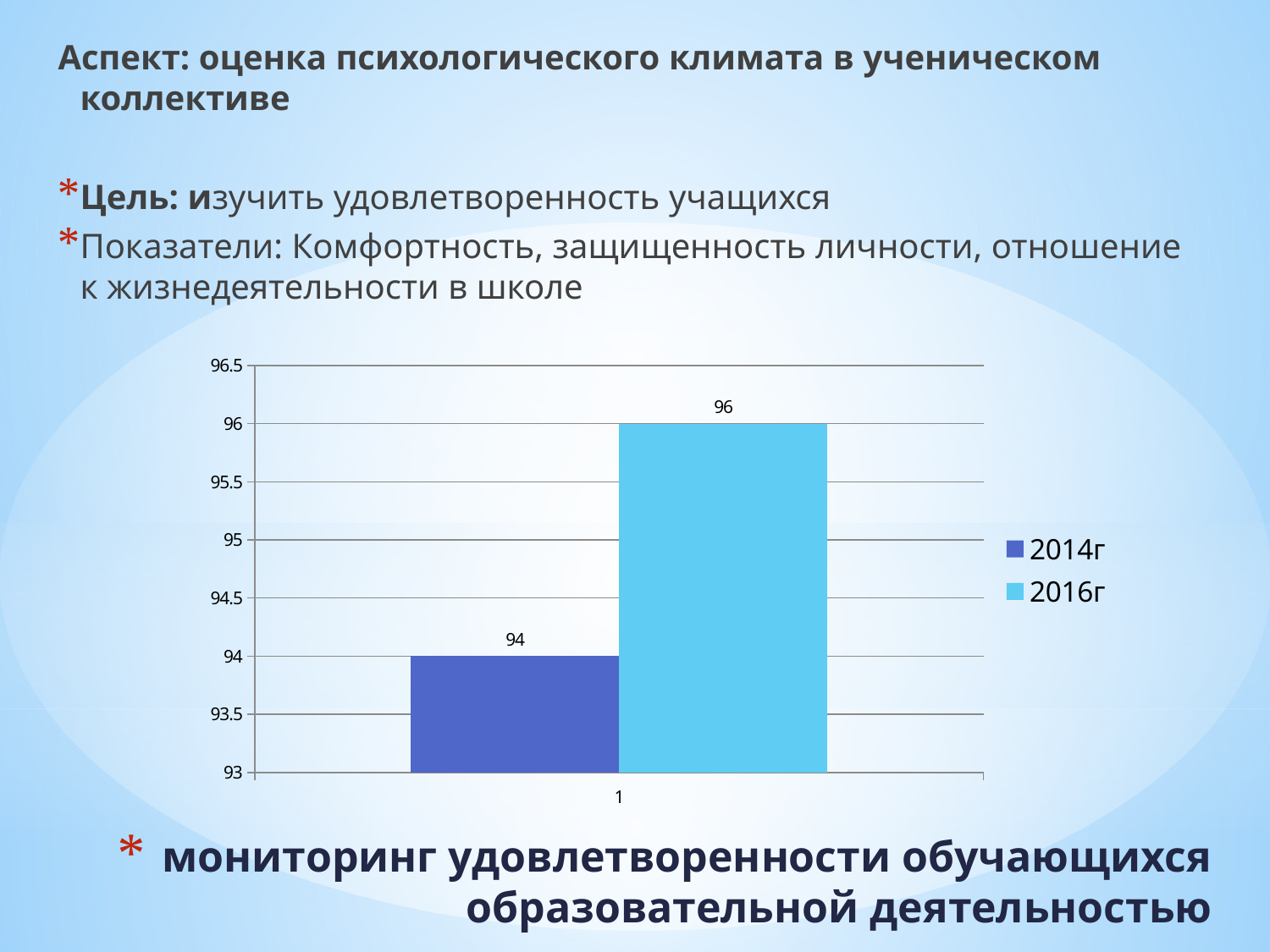
What is the value for the 2014г series? 94 What is the highest value shown on the y axis? 96.5 Is the value for 2014г greater or less than 95? less What is the value for the 2016г series? 96 What kind of chart is shown on the slide? bar chart What is the category label shown on the x axis? 1 Which series has the lower value? 2014г How many series does the legend list? 2 Which series has the higher value, 2014г or 2016г? 2016г Did the value rise or fall from 2014г to 2016г? rise Is the value for 2016г greater or less than 95? greater What is the difference between the 2016г value and the 2014г value? 2